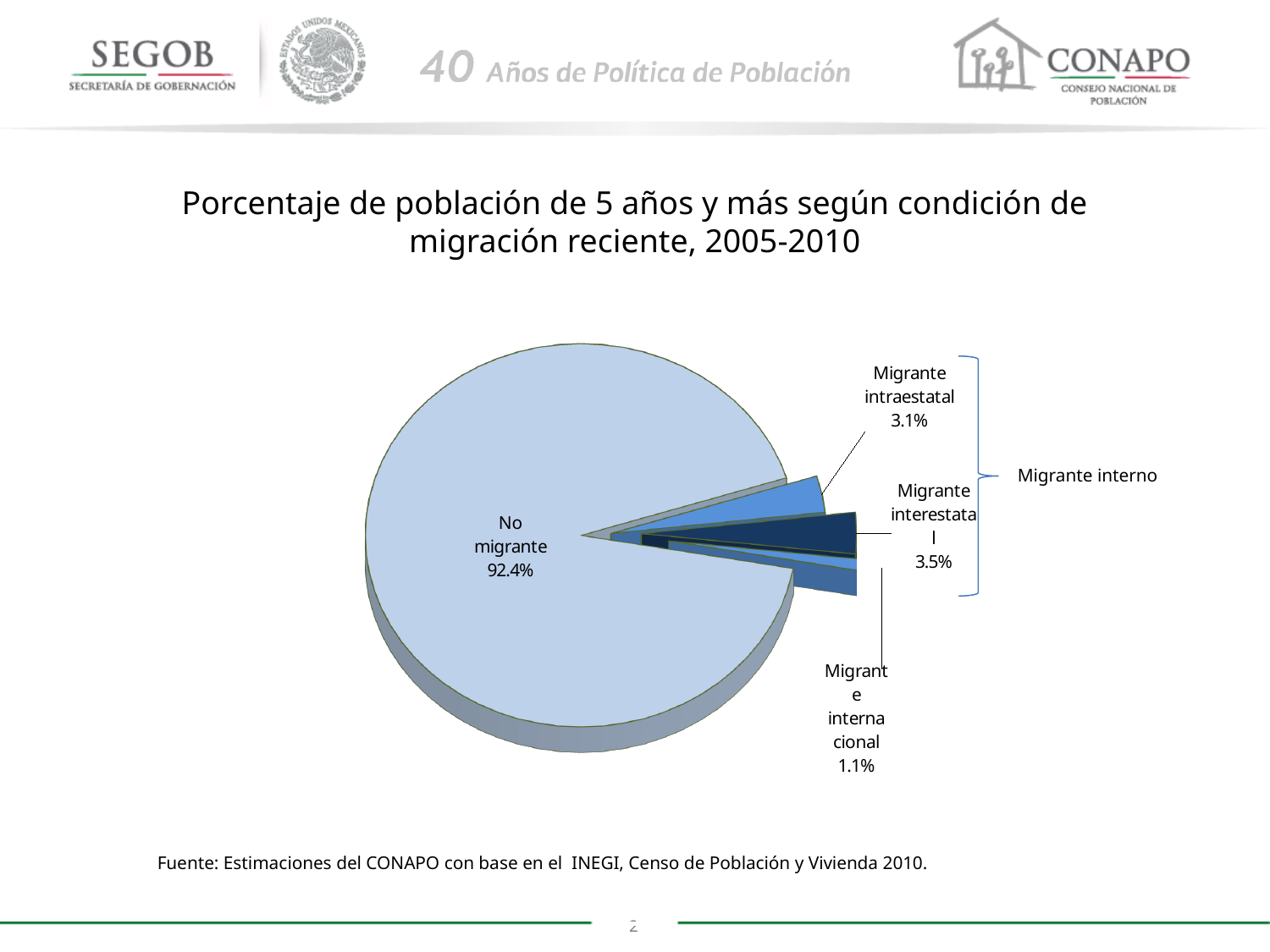
What percentage of the population is labelled "No migrante"? 92.4% What is the value shown for "Migrante intraestatal"? 3.1% What is the value shown for "Migrante internacional"? 1.1% Which is larger, Migrante interestatal or Migrante intraestatal? Migrante interestatal How many slices does the pie chart have? 4 What is the value shown for "Migrante interestatal"? 3.5% Which slice of the pie is the largest? No migrante Which slice of the pie is the smallest? Migrante internacional What kind of chart is shown on the slide? pie chart What label does the bracket to the right of the pie group the intraestatal and interestatal slices under? Migrante interno What is the combined percentage of Migrante intraestatal and Migrante interestatal (the slices bracketed as Migrante interno)? 6.6% What is the difference between the Migrante interestatal and Migrante intraestatal percentages? 0.4%